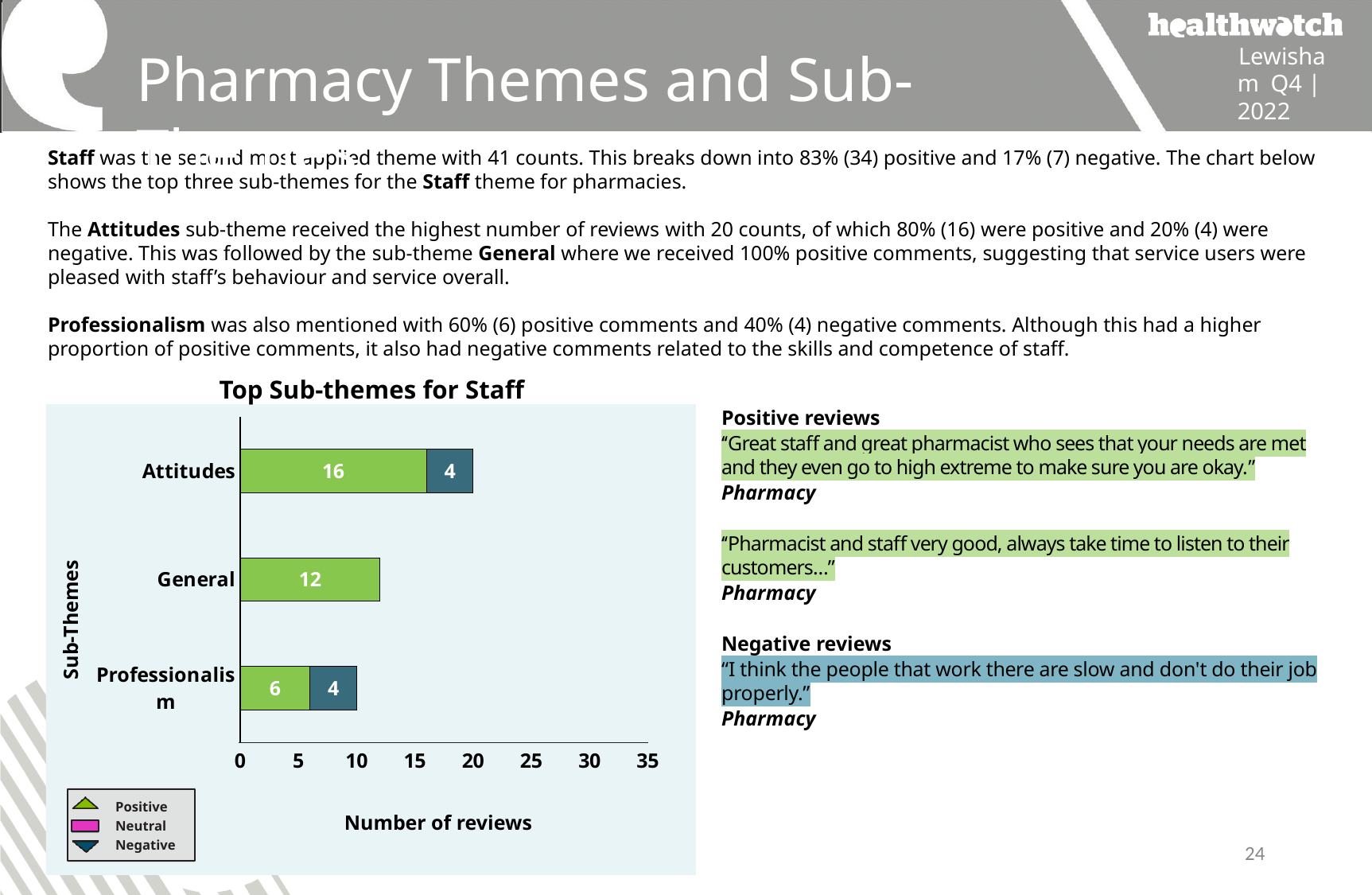
What type of chart is 'Top Sub-themes for Staff'? Stacked bar chart What is the Positive value for Attitudes in the 'Top Sub-themes for Staff' chart? 16 What is the Positive value for General in the 'Top Sub-themes for Staff' chart? 12 What is the total number of reviews for Attitudes in the 'Top Sub-themes for Staff' chart? 20 How many sub-themes are shown in the 'Top Sub-themes for Staff' chart? 3 What is the difference between the Positive values for Attitudes and General in the 'Top Sub-themes for Staff' chart? 4 How many series does the legend of the 'Top Sub-themes for Staff' chart list? 3 Which sub-theme has the highest Positive value in the 'Top Sub-themes for Staff' chart? Attitudes What is the Negative value for Professionalism in the 'Top Sub-themes for Staff' chart? 4 Which sub-theme has the lowest Positive value in the 'Top Sub-themes for Staff' chart? Professionalism What is the label of the x axis in the 'Top Sub-themes for Staff' chart? Number of reviews What is the total number of reviews for Professionalism in the 'Top Sub-themes for Staff' chart? 10